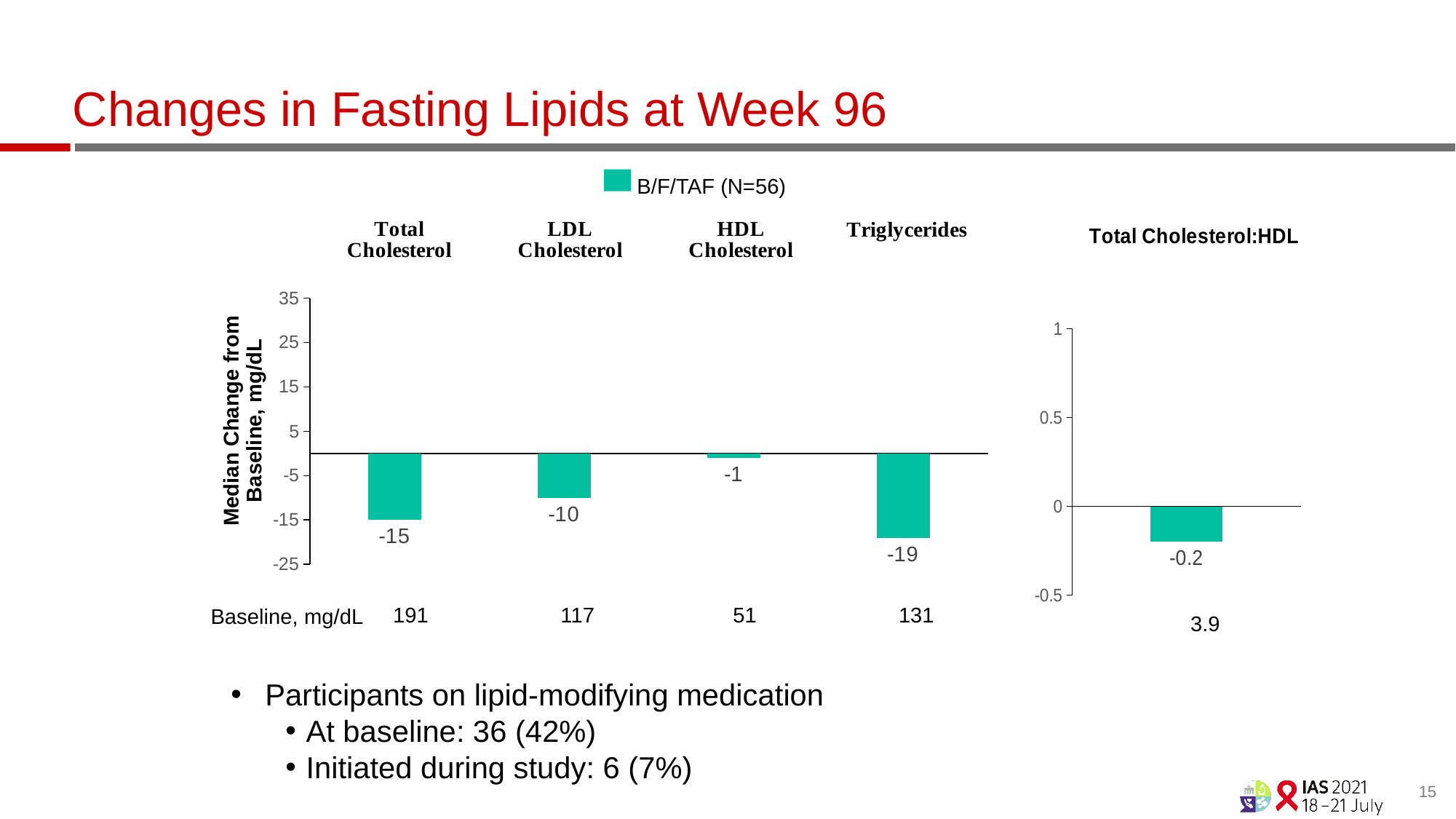
What series does the legend list, and what is its sample size? B/F/TAF (N=56) In the left chart, what is the median change from baseline for LDL Cholesterol? -10 In the left chart, which lipid parameter shows the smallest change from baseline? HDL Cholesterol How many lipid categories are plotted in the left chart? 4 In the left chart, which lipid parameter shows the largest decrease from baseline? Triglycerides What type of chart is used on this slide? Bar chart In the left chart, is the decrease for LDL Cholesterol larger or smaller than the decrease for Total Cholesterol? smaller In the left chart, what is the median change from baseline for HDL Cholesterol? -1 In the left chart, what is the median change from baseline for Triglycerides? -19 In the left chart, what is the difference between the median change for Triglycerides and for Total Cholesterol? 4 In the right chart (Total Cholesterol:HDL), what is the median change from baseline? -0.2 In the left chart (Median Change from Baseline, mg/dL), what is the median change for Total Cholesterol? -15